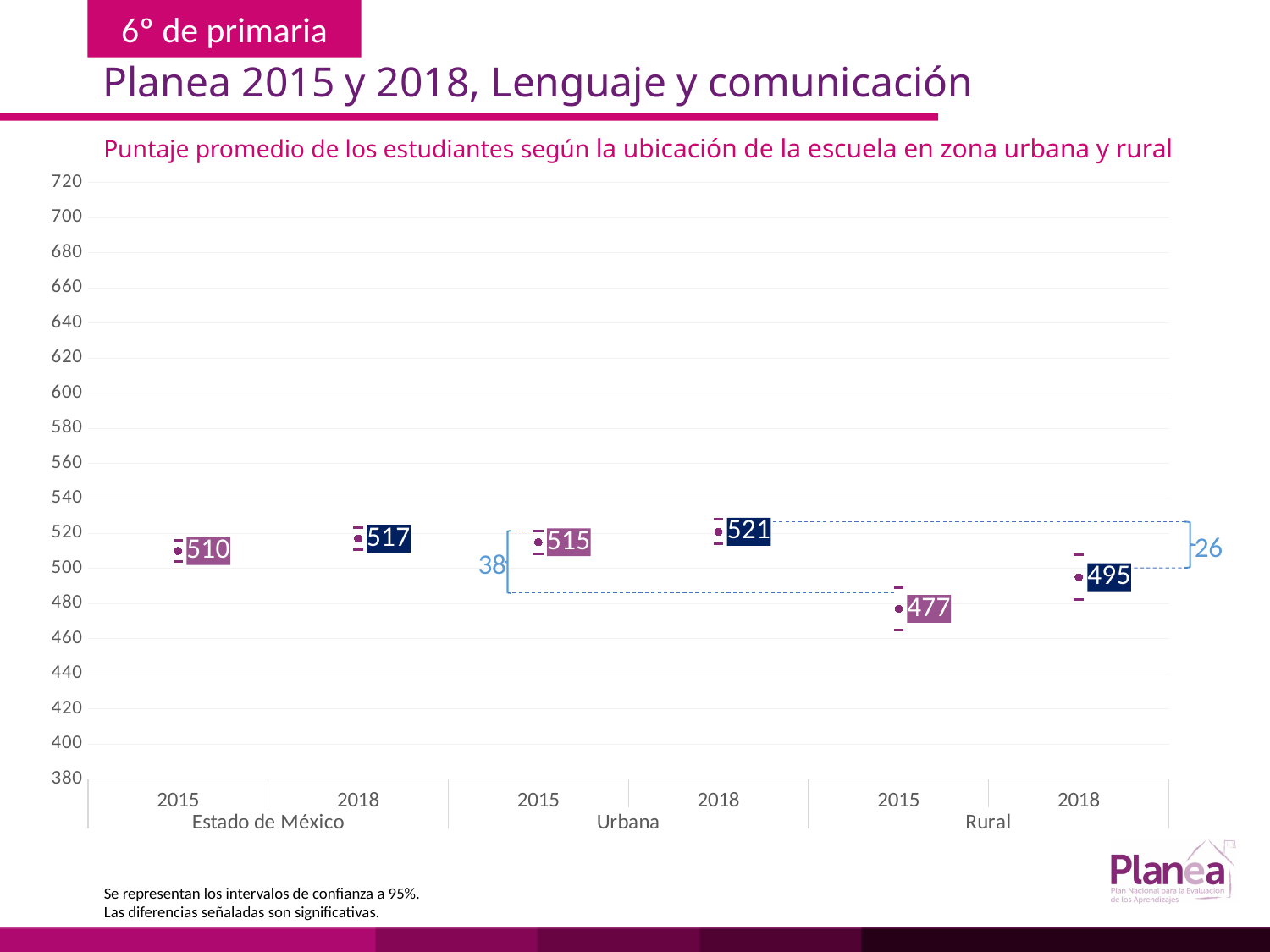
What is the difference between the Rural scores in 2018 and 2015? 18 Which is larger, the Urbana 2015 score or the Estado de México 2015 score? Urbana 2015 Which group and year has the highest average score? Urbana 2018 What is the difference between the Estado de México scores in 2018 and 2015? 7 What is the average score for Rural schools in 2018? 495 What is the average score for Rural schools in 2015? 477 What is the average score for Estado de México in 2015? 510 What is the subtitle of the chart? Puntaje promedio de los estudiantes según la ubicación de la escuela en zona urbana y rural Is the Rural 2015 score greater or less than 480? less Which group and year has the lowest average score? Rural 2015 How many data points are plotted on the chart? 6 What is the average score for Urbana schools in 2018? 521